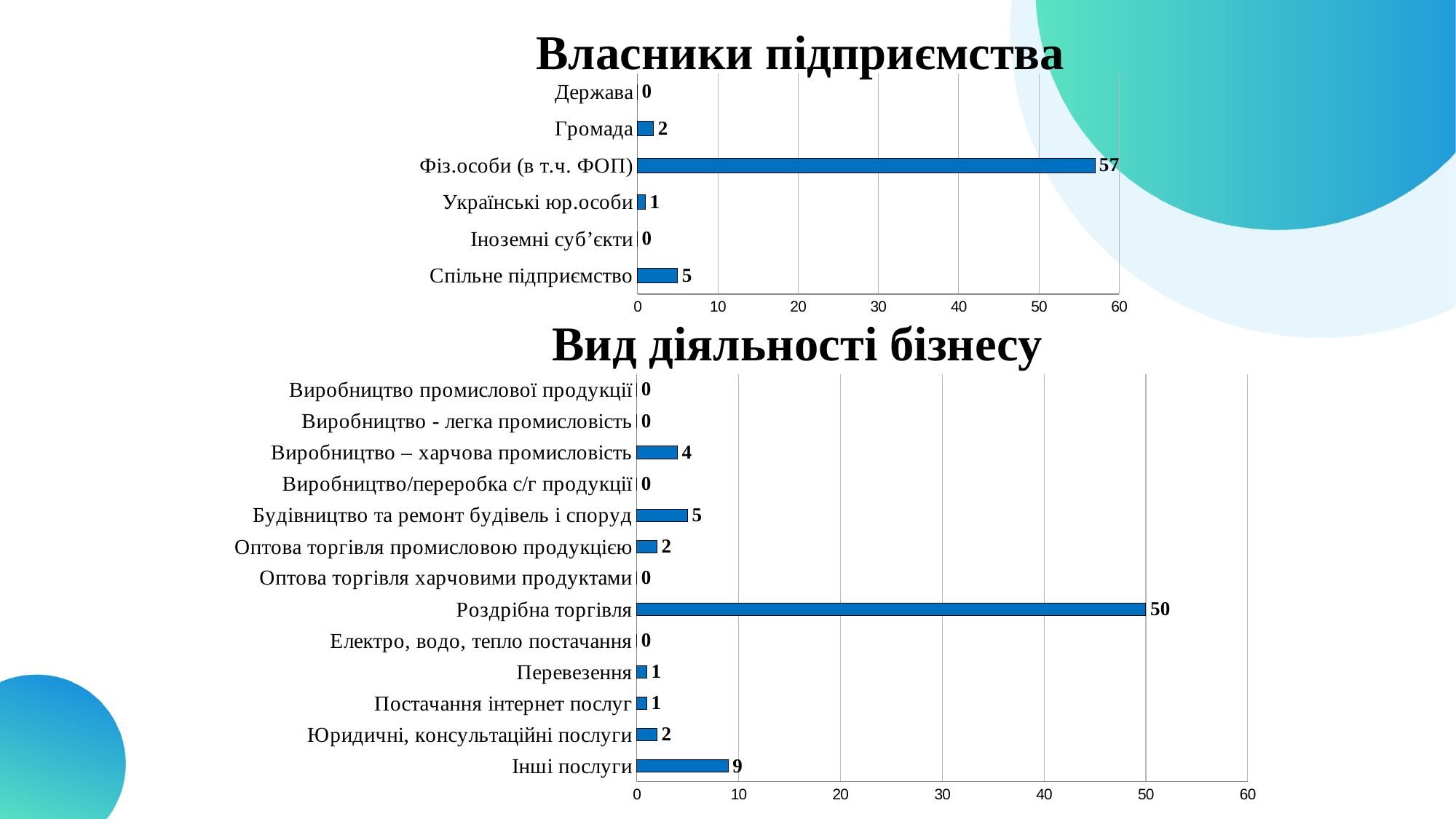
In the chart titled "Власники підприємства", what is the difference between the values for Спільне підприємство and Громада? 3 In the chart titled "Вид діяльності бізнесу", which category has the highest value? Роздрібна торгівля In the chart titled "Власники підприємства", what is the value for Спільне підприємство? 5 In the chart titled "Вид діяльності бізнесу", what is the value for Роздрібна торгівля? 50 In the chart titled "Власники підприємства", how many categories are shown? 6 What type of chart is the chart titled "Вид діяльності бізнесу"? Bar chart In the chart titled "Вид діяльності бізнесу", how many categories are shown? 13 In the chart titled "Вид діяльності бізнесу", which is larger: the value for Інші послуги or the value for Виробництво – харчова промисловість? Інші послуги In the chart titled "Власники підприємства", what is the value for Фіз.особи (в т.ч. ФОП)? 57 In the chart titled "Вид діяльності бізнесу", what is the value for Будівництво та ремонт будівель і споруд? 5 In the chart titled "Власники підприємства", which category has the highest value? Фіз.особи (в т.ч. ФОП) In the chart titled "Вид діяльності бізнесу", what is the value for Інші послуги? 9